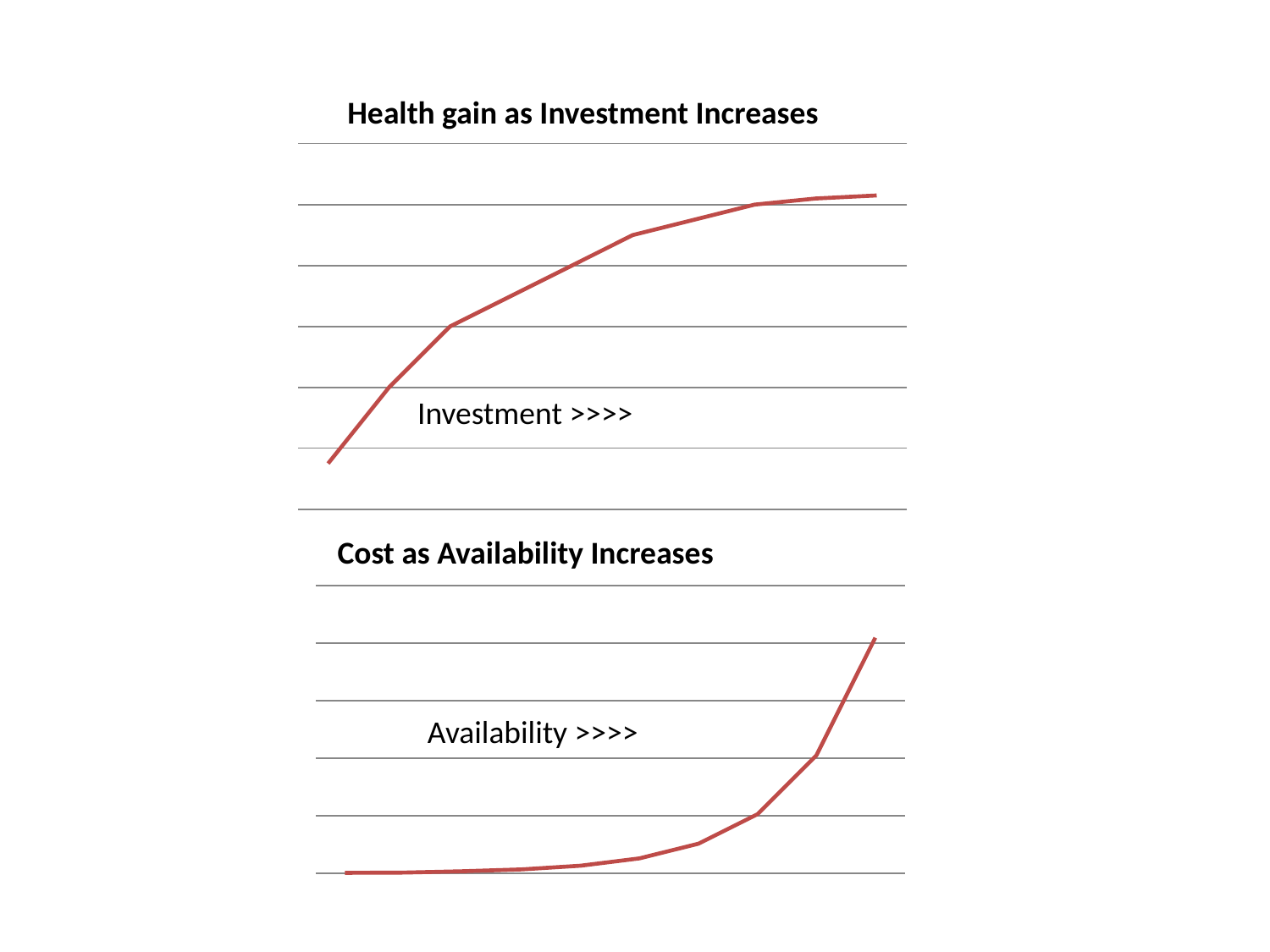
What kind of chart is the 'Health gain as Investment Increases' chart? line chart What is the title of the bottom chart? Cost as Availability Increases In the 'Health gain as Investment Increases' chart, does the line rise more steeply at the left end or the right end? left end In the 'Health gain as Investment Increases' chart, do the values rise or fall as investment increases along the x axis? rise In the 'Cost as Availability Increases' chart, does the line rise more steeply at the left end or the right end? right end What is the x-axis label shown on the top chart? Investment >>>> What kind of chart is the 'Cost as Availability Increases' chart? line chart